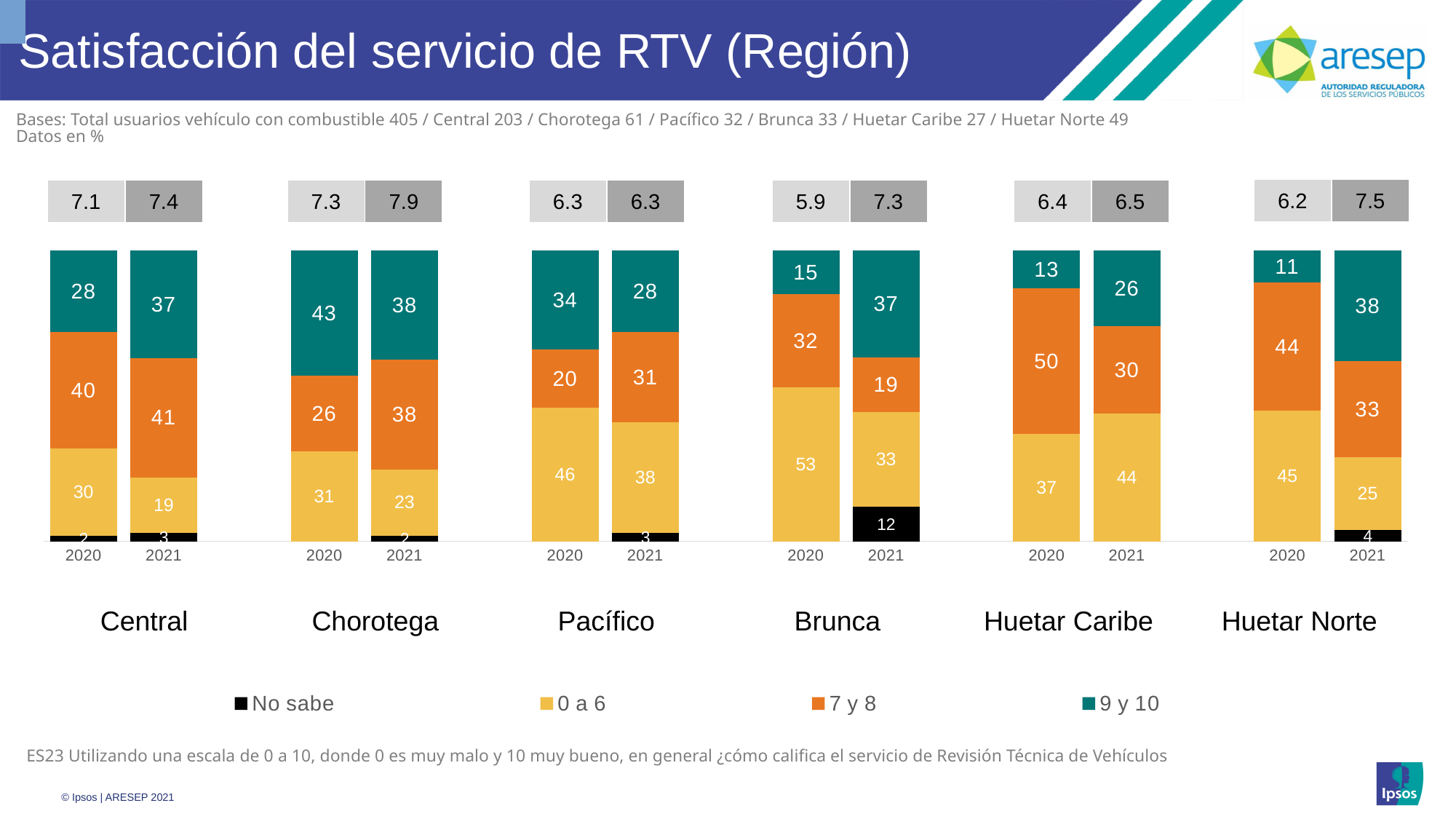
What is the No sabe value for Brunca in 2021? 12 What is the average score shown above the 2021 bar for Chorotega? 7.9 What kind of chart is shown on the slide? Stacked bar chart How many regions are shown in the chart? 6 What percentage of Central users rated the RTV service 9 y 10 in 2021? 37 Which region has the highest 0 a 6 value in 2020? Brunca How many series does the legend list? 4 By how many points did the 9 y 10 segment for Chorotega change from 2020 to 2021? 5 What is the total of the stacked bar for Huetar Norte in 2021? 100 What is the value of the 7 y 8 segment for Huetar Caribe in 2020? 50 Which region has the lowest 9 y 10 value in 2020? Huetar Norte For Pacífico, is the 0 a 6 value larger in 2020 or in 2021? 2020